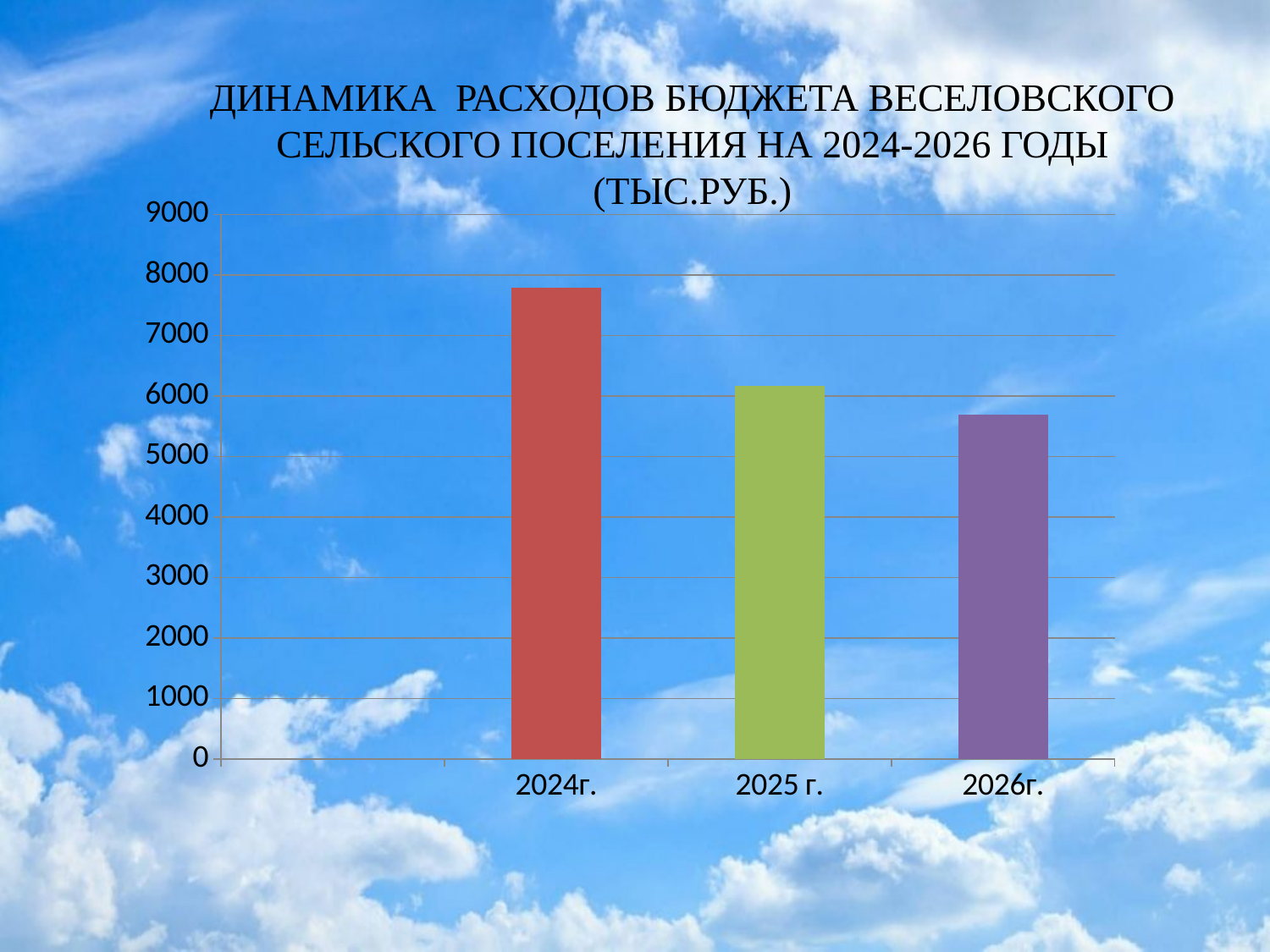
Which year has the highest budget expenditure in the chart? 2024г. Which is larger, the value for 2024г. or the value for 2025 г.? 2024г. What colour is the bar for 2025 г.? green Which is larger, the value for 2025 г. or the value for 2026г.? 2025 г. Do the values rise or fall from 2024г. to 2026г.? fall Is the value for 2024г. greater or less than 7000? greater Is the value for 2025 г. greater or less than 6000? greater What kind of chart is shown on the slide? bar chart Which year has the lowest budget expenditure in the chart? 2026г. Is the value for 2026г. greater or less than 6000? less How many years (categories) are shown in the chart? 3